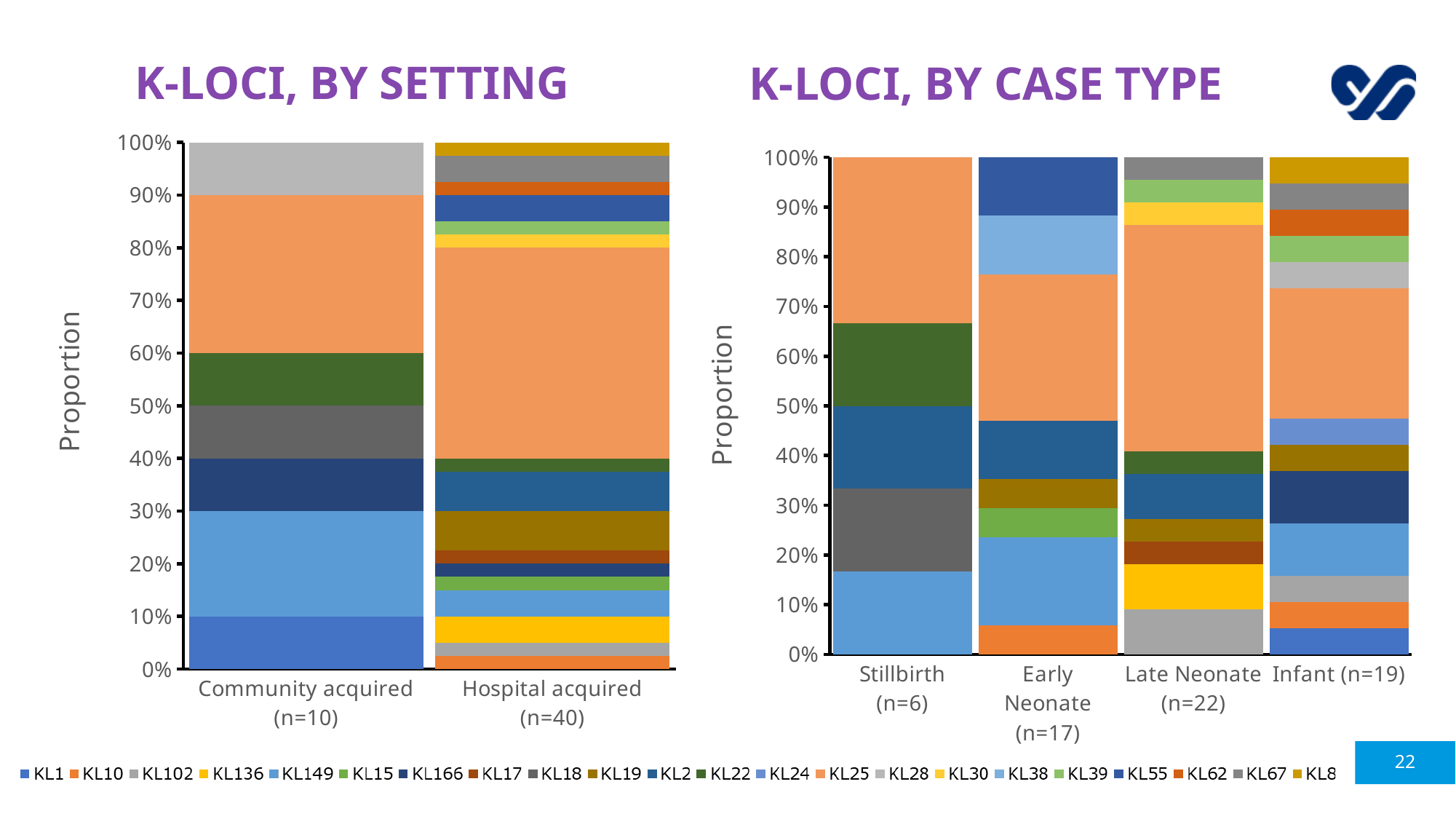
In the 'K-LOCI, BY CASE TYPE' chart, which case type has the smallest sample size? Stillbirth (n=6) How many case types are shown on the x axis of the 'K-LOCI, BY CASE TYPE' chart? 4 In the 'K-LOCI, BY CASE TYPE' chart, is the bottom segment of the Stillbirth bar greater or less than 10%? greater How many categories are shown on the x axis of the 'K-LOCI, BY SETTING' chart? 2 What is the y-axis label on the 'K-LOCI, BY CASE TYPE' chart? Proportion In the 'K-LOCI, BY SETTING' chart, is the bottom segment of the Hospital acquired bar greater or less than 10%? less In the 'K-LOCI, BY SETTING' chart, what proportion does the bottom segment of the Community acquired bar reach? 10% In the 'K-LOCI, BY SETTING' chart, what sample size is given for the Hospital acquired category? n=40 How many K-loci series does the legend at the bottom of the slide list? 22 What kind of chart is 'K-LOCI, BY SETTING'? stacked bar chart In the 'K-LOCI, BY CASE TYPE' chart, which bar has the larger KL25 (light orange) segment, Stillbirth or Late Neonate? Late Neonate In the 'K-LOCI, BY CASE TYPE' chart, is the bottom segment of the Late Neonate bar greater or less than 20%? less